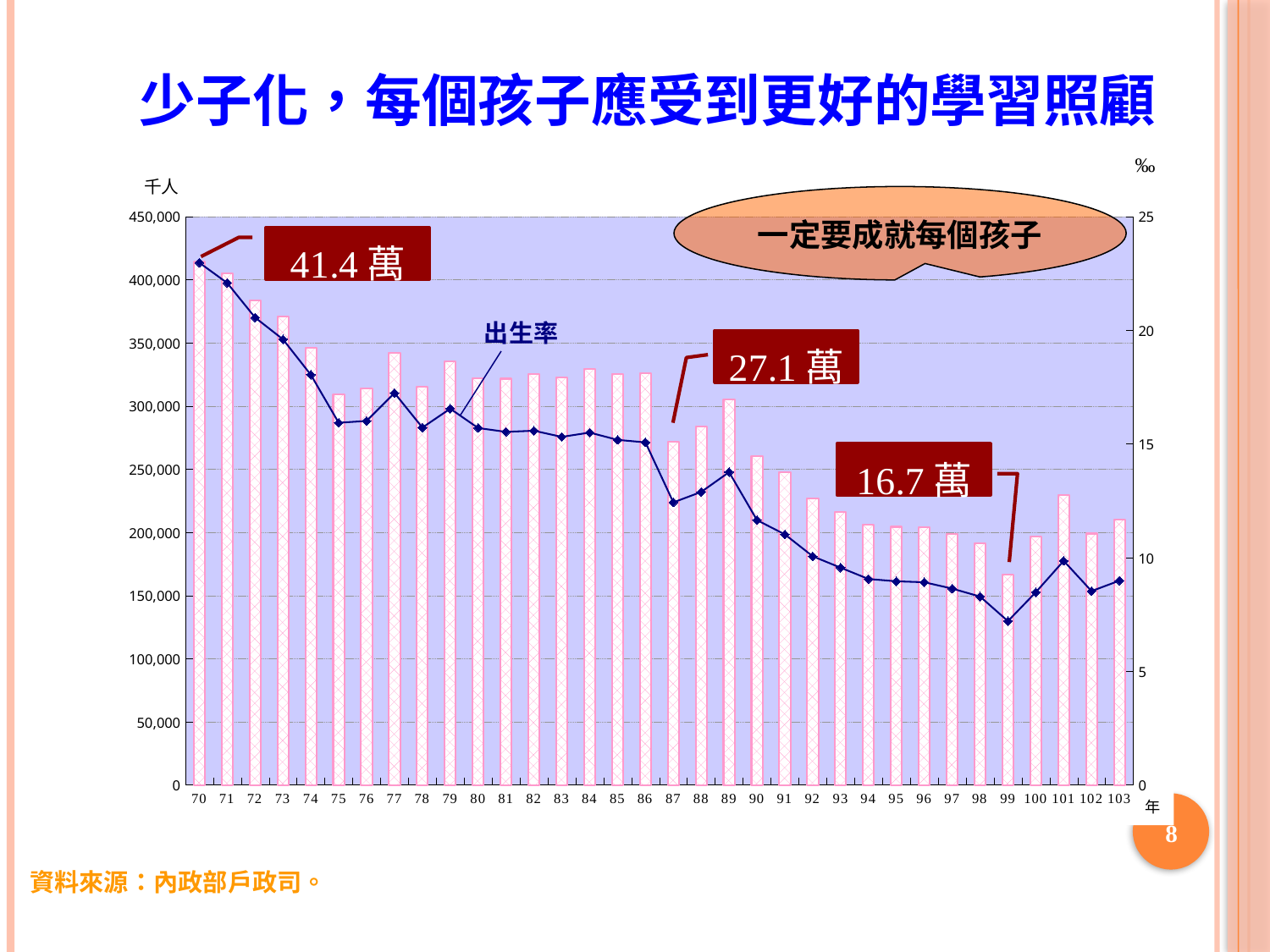
Which year has the shortest bar in the chart? 99 What value does the annotation give for the number of births in year 87? 27.1 萬 Is the bar for year 70 greater or less than 400,000? greater What value does the annotation give for the number of births in year 70? 41.4 萬 What kind of chart is shown on the slide? A combined bar and line chart Is the birth rate (出生率) line value for year 99 greater or less than 10‰? less What value does the annotation give for the number of births in year 99? 16.7 萬 Overall, do the bar values rise or fall from year 70 to year 103? fall How many years are shown along the x axis of the chart? 34 Which year has the tallest bar in the chart? 70 Which year has a taller bar, year 87 or year 99? 87 What is the difference between the annotated values for year 70 and year 99? 24.7 萬